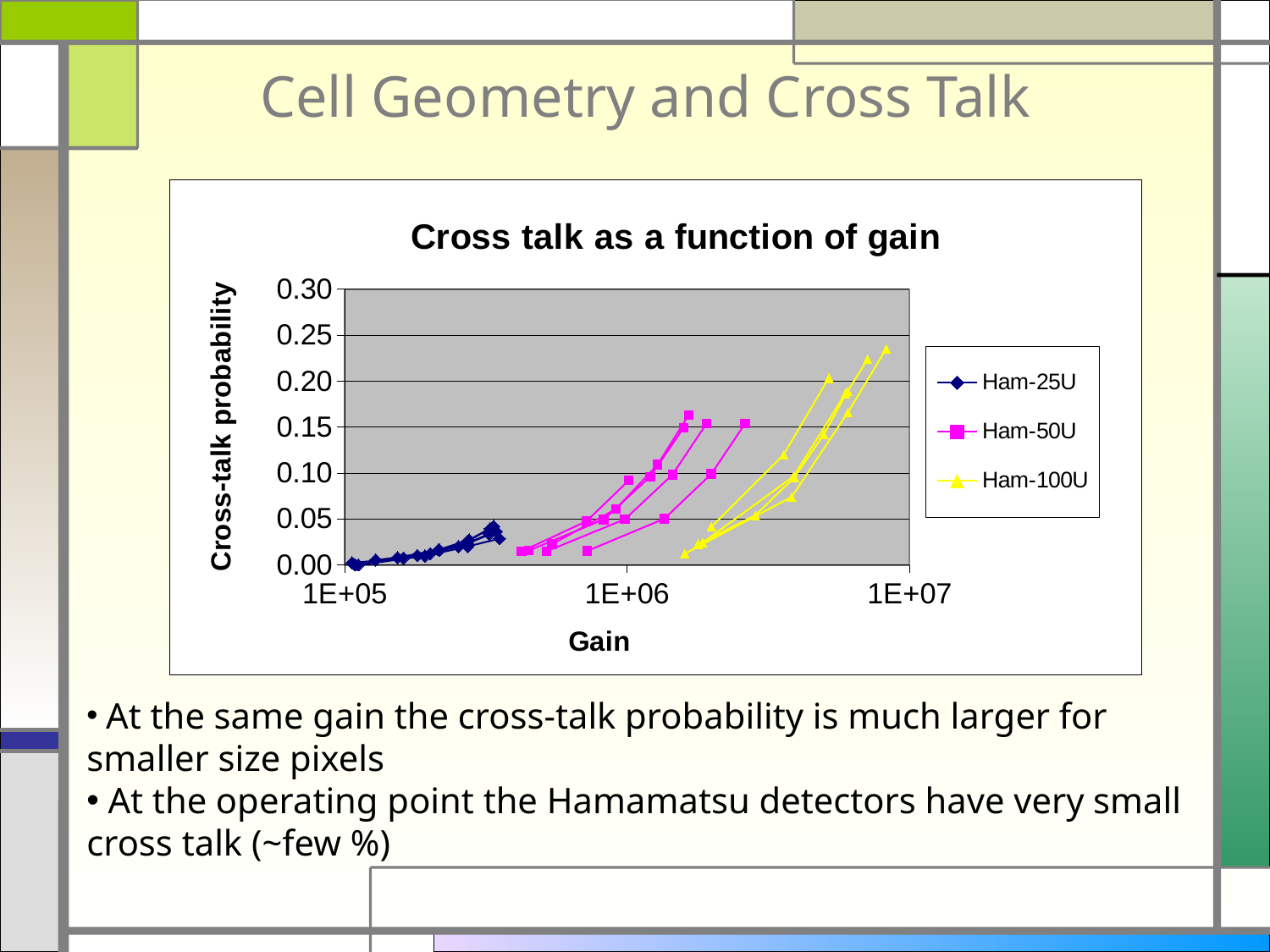
What is the label of the x axis? Gain Which series has its data points at lower gain values, Ham-25U or Ham-100U? Ham-25U Does the cross-talk probability rise or fall as gain increases for each series? Rise Which series stays at the lowest cross-talk probability values on the chart? Ham-25U What is the title of the chart? Cross talk as a function of gain Is the highest cross-talk probability reached by the Ham-25U series greater or less than 0.05? less What kind of chart is shown on the slide? Line chart with markers (scatter plot) Which series reaches the highest cross-talk probability on the chart? Ham-100U How many series does the chart legend list? 3 Which series are listed in the chart legend? Ham-25U, Ham-50U, Ham-100U Is the highest cross-talk probability reached by the Ham-100U series greater or less than 0.20? greater